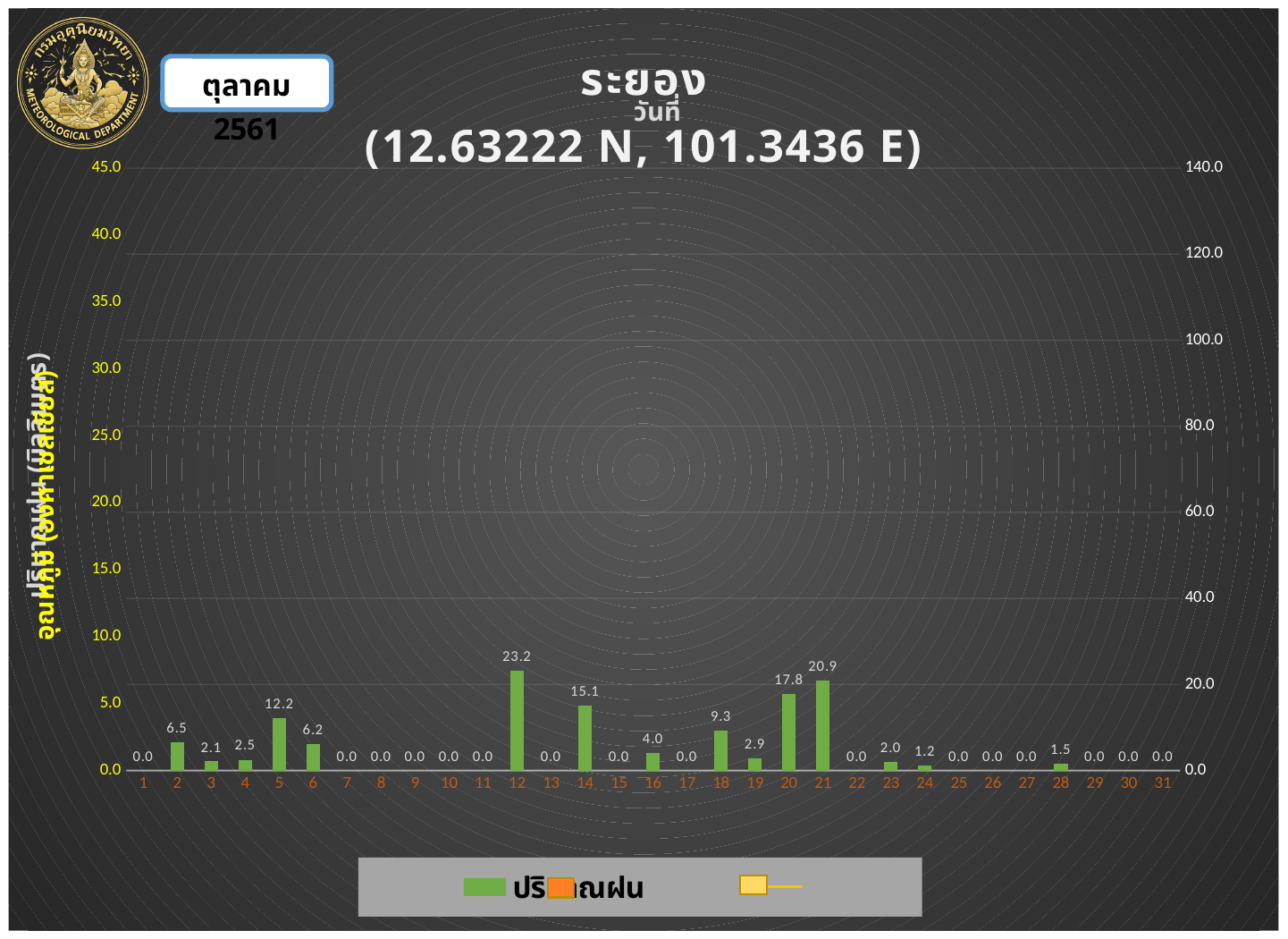
Which is larger, the value for day 14 or the value for day 18? day 14 What is the difference between the values for day 20 and day 14? 2.7 Which is larger, the value for day 2 or the value for day 6? day 2 What is the value shown for day 12? 23.2 What kind of chart is shown on the slide? bar chart What is the difference between the values for day 12 and day 21? 2.3 How many days are shown on the x axis? 31 Which day has the highest value? 12 What is the value shown for day 21? 20.9 What is the value shown for day 5? 12.2 What is the value shown for day 18? 9.3 What station name is shown in the chart title? ระยอง